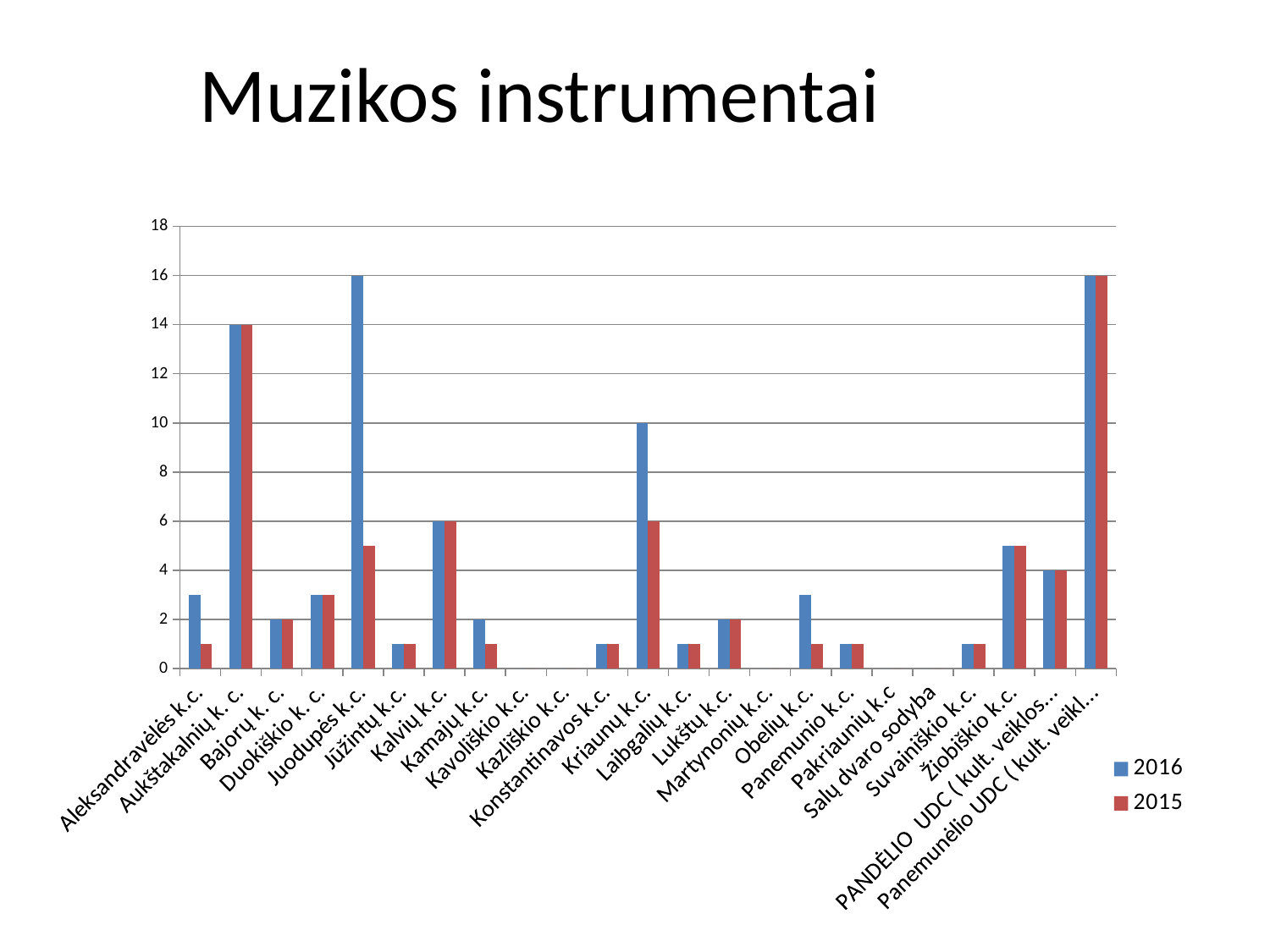
What is the title of the chart? Muzikos instrumentai What is the 2015 value for Aukštakalnių k. c.? 14 What type of chart is shown on the slide? bar chart How many categories are shown on the x axis? 23 What is the 2016 value for Kriaunų k.c.? 10 Which category has the highest 2015 value? Panemunėlio UDC ( kult. veikl... Is the 2016 value for Aleksandravėlės k.c. greater or less than 2? greater For Kriaunų k.c., which is larger: the 2016 value or the 2015 value? 2016 What is the difference between the 2016 and 2015 values for Kriaunų k.c.? 4 What is the 2016 value for Juodupės k.c.? 16 Is the 2015 value for Juodupės k.c. greater or less than 4? greater How many series does the legend list? 2